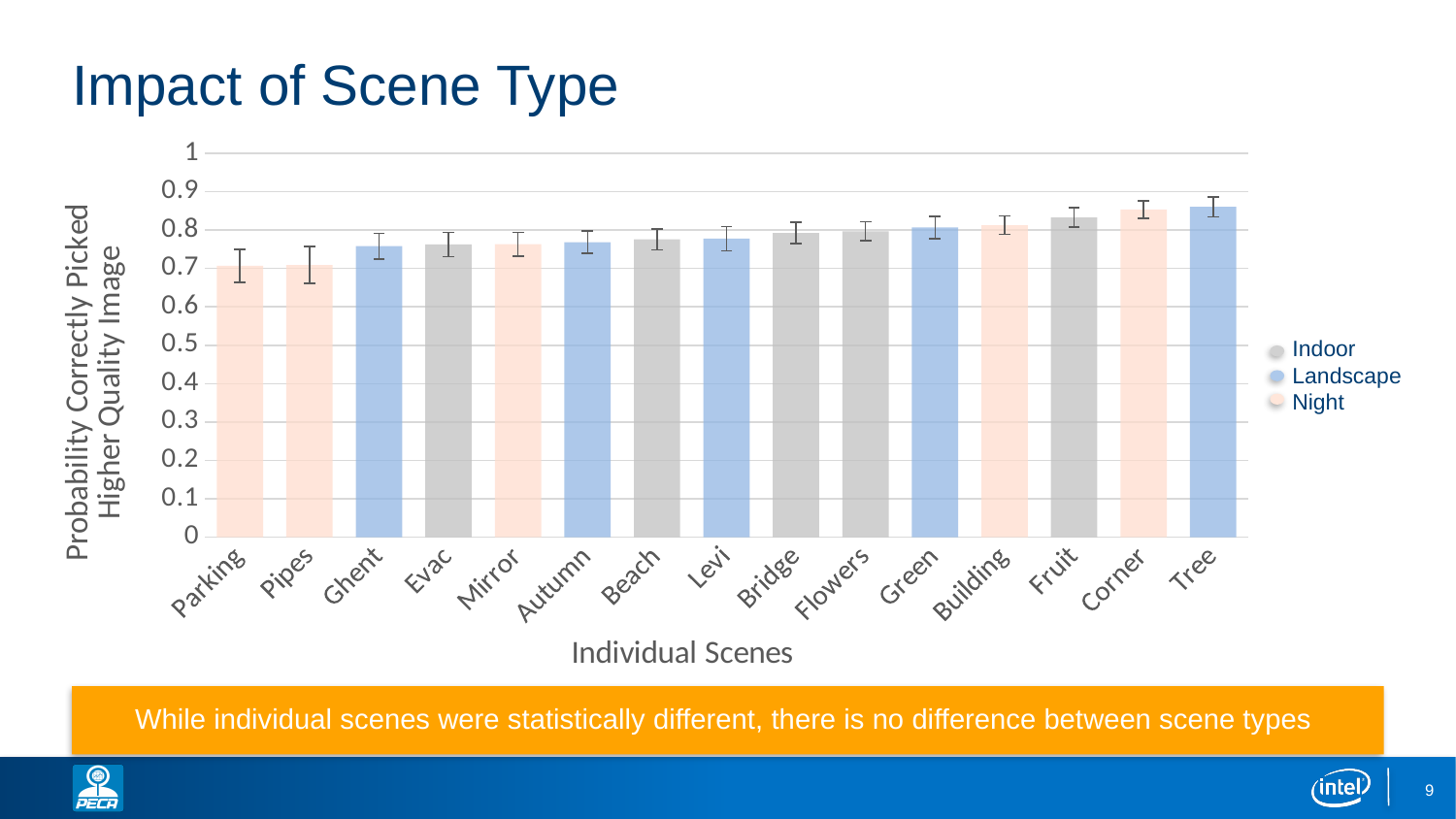
What kind of chart is shown on the slide? bar chart Is the value for Parking greater or less than 0.8? less How many series does the legend list? 3 Do the bar values rise or fall moving from left to right along the x axis? rise How many individual scenes are plotted along the x axis? 15 Which has the higher probability, Tree or Parking? Tree Is the value for Fruit greater or less than 0.8? greater Is the value for Tree greater or less than 0.8? greater What is the title of the chart's x axis? Individual Scenes Which scene type does the legend associate with the blue bars? Landscape Which has the lower probability, Pipes or Corner? Pipes